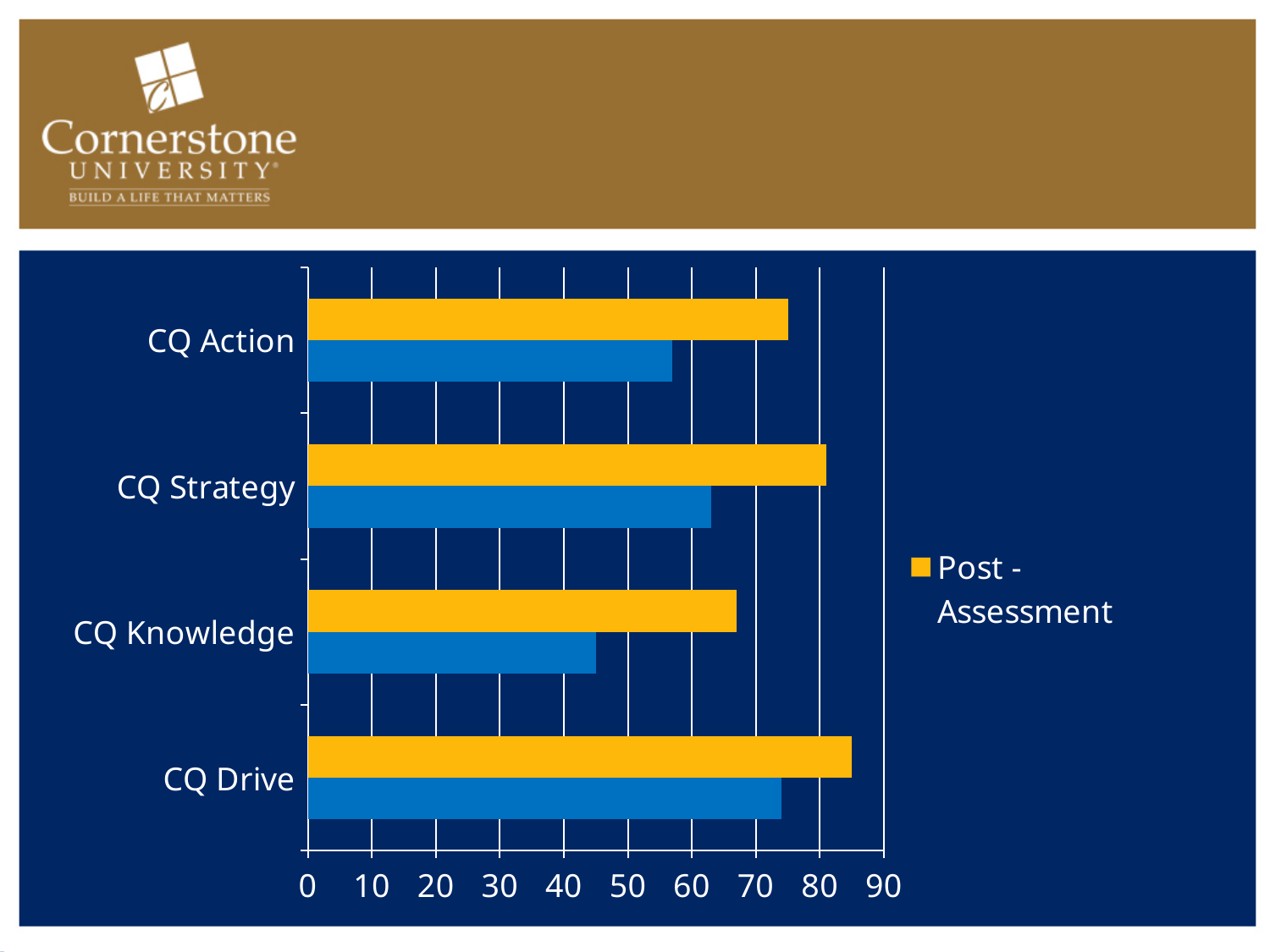
Which category has the lowest value for the blue series? CQ Knowledge Is the Post - Assessment value for CQ Knowledge greater or less than 70? less Is the Post - Assessment value for CQ Action greater or less than 70? greater What kind of chart is shown on the slide? bar chart Is the Post - Assessment value for CQ Drive greater or less than 80? greater How many series does the legend list? 1 What is the name of the series listed in the legend? Post - Assessment Which category has the lowest Post - Assessment value? CQ Knowledge Which category has the highest Post - Assessment value? CQ Drive How many categories are shown on the chart? 4 Which is larger, the Post - Assessment value for CQ Strategy or for CQ Knowledge? CQ Strategy